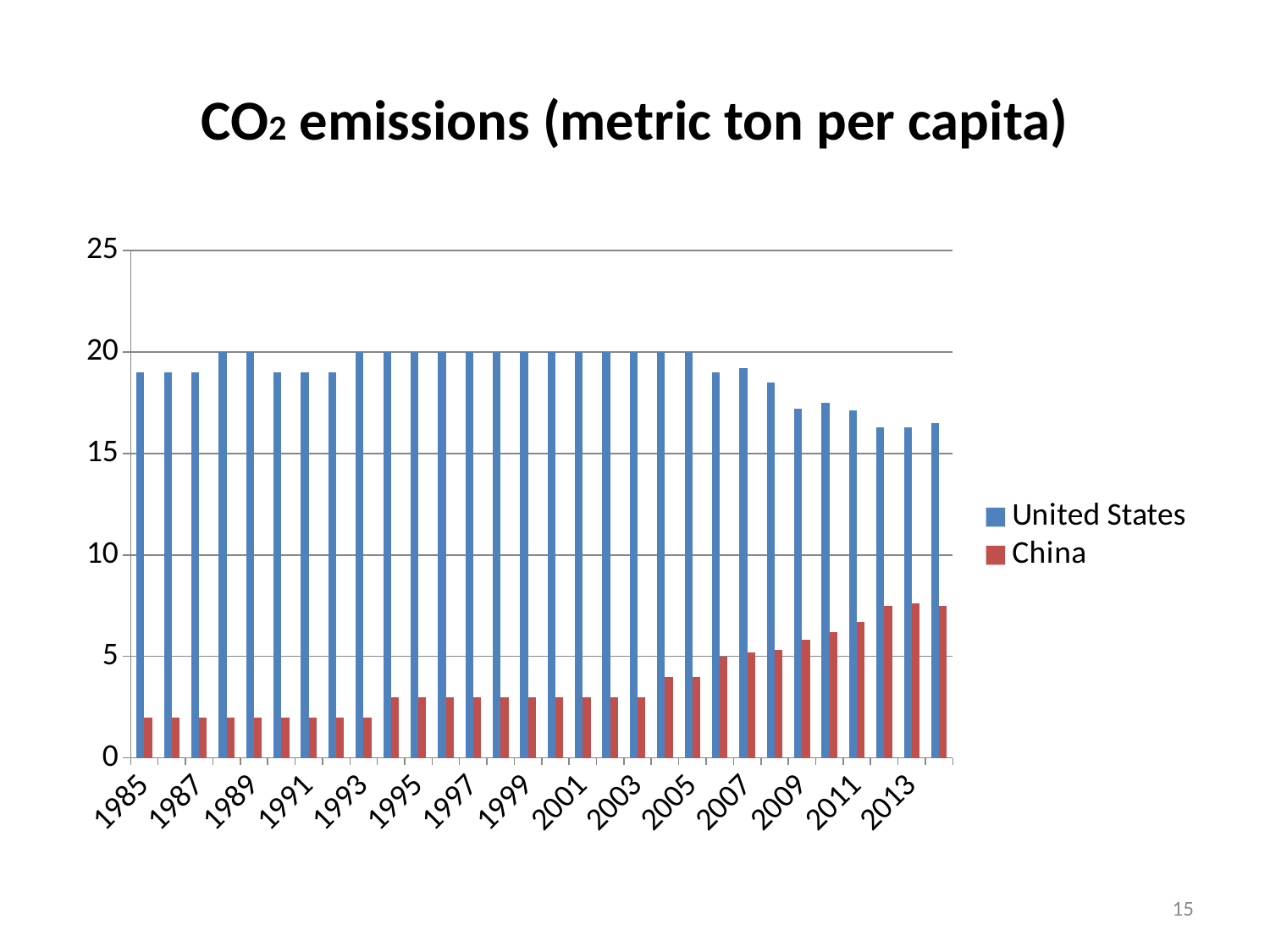
Is the value for China in 2013 greater or less than 5? greater What is the title of the chart? CO2 emissions (metric ton per capita) Is the value for the United States in 2009 greater or less than 20? less Is the value for the United States in 2013 greater or less than 15? greater Do the values for China rise or fall from 1985 to 2013? rise Which series is shown in red? China In 2013, which is larger, the value for the United States or the value for China? United States What kind of chart is shown on the slide? bar chart How many series does the legend list? 2